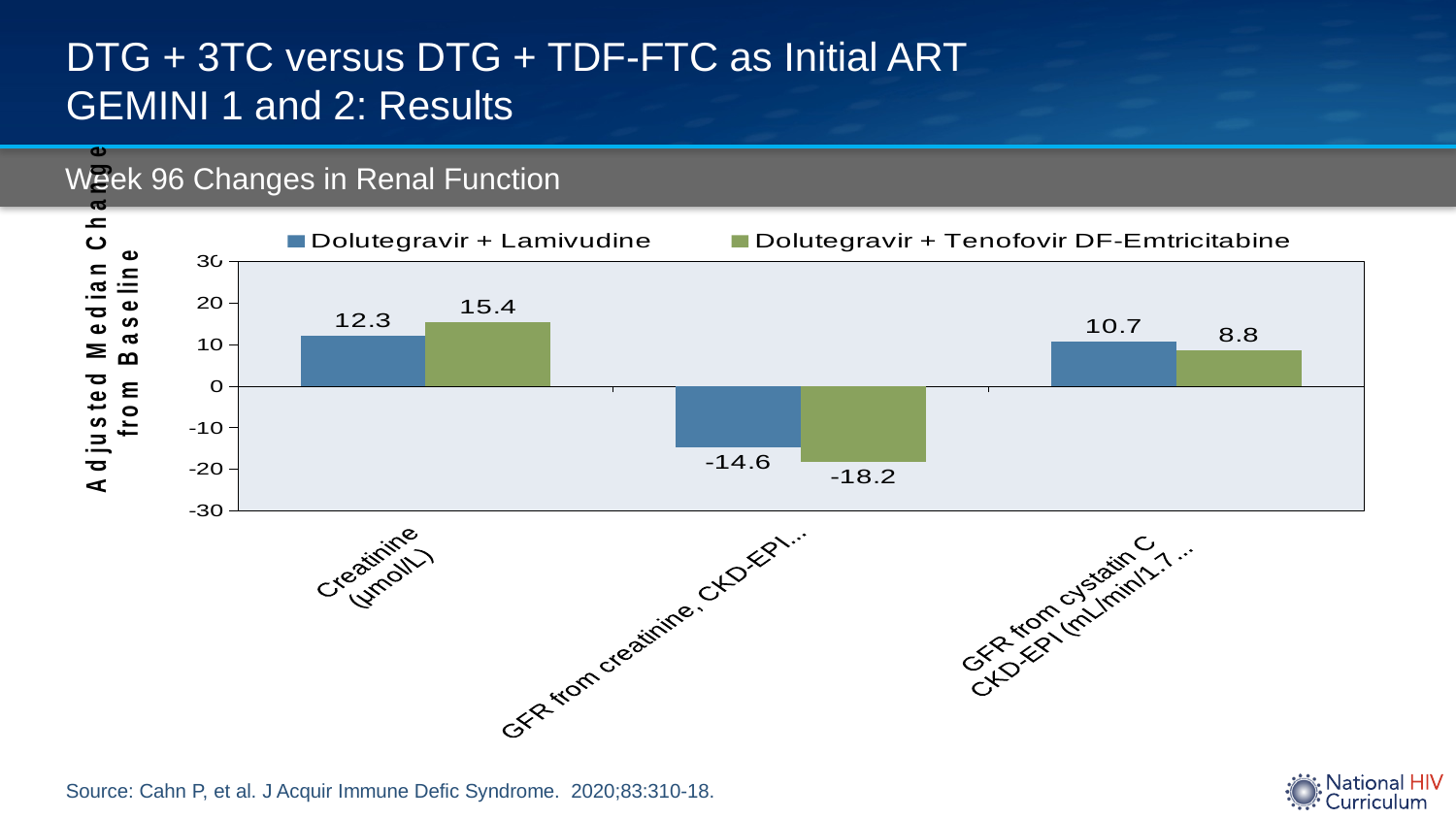
What is the difference between the Dolutegravir + Tenofovir DF-Emtricitabine and Dolutegravir + Lamivudine values in the Creatinine (µmol/L) category? 3.1 How many series does the legend list? 2 Which category has the highest value for the Dolutegravir + Tenofovir DF-Emtricitabine series? Creatinine (µmol/L) What is the value for Dolutegravir + Lamivudine in the GFR from cystatin C CKD-EPI category? 10.7 What is the value for Dolutegravir + Tenofovir DF-Emtricitabine in the GFR from cystatin C CKD-EPI category? 8.8 What is the value for Dolutegravir + Tenofovir DF-Emtricitabine in the Creatinine (µmol/L) category? 15.4 Which category has the lowest value for the Dolutegravir + Lamivudine series? GFR from creatinine, CKD-EPI What is the value for Dolutegravir + Lamivudine in the Creatinine (µmol/L) category? 12.3 What is the value for Dolutegravir + Tenofovir DF-Emtricitabine in the GFR from creatinine, CKD-EPI category? -18.2 What kind of chart is shown on the slide? Bar chart What is the value for Dolutegravir + Lamivudine in the GFR from creatinine, CKD-EPI category? -14.6 In the GFR from cystatin C CKD-EPI category, which series has the larger value? Dolutegravir + Lamivudine